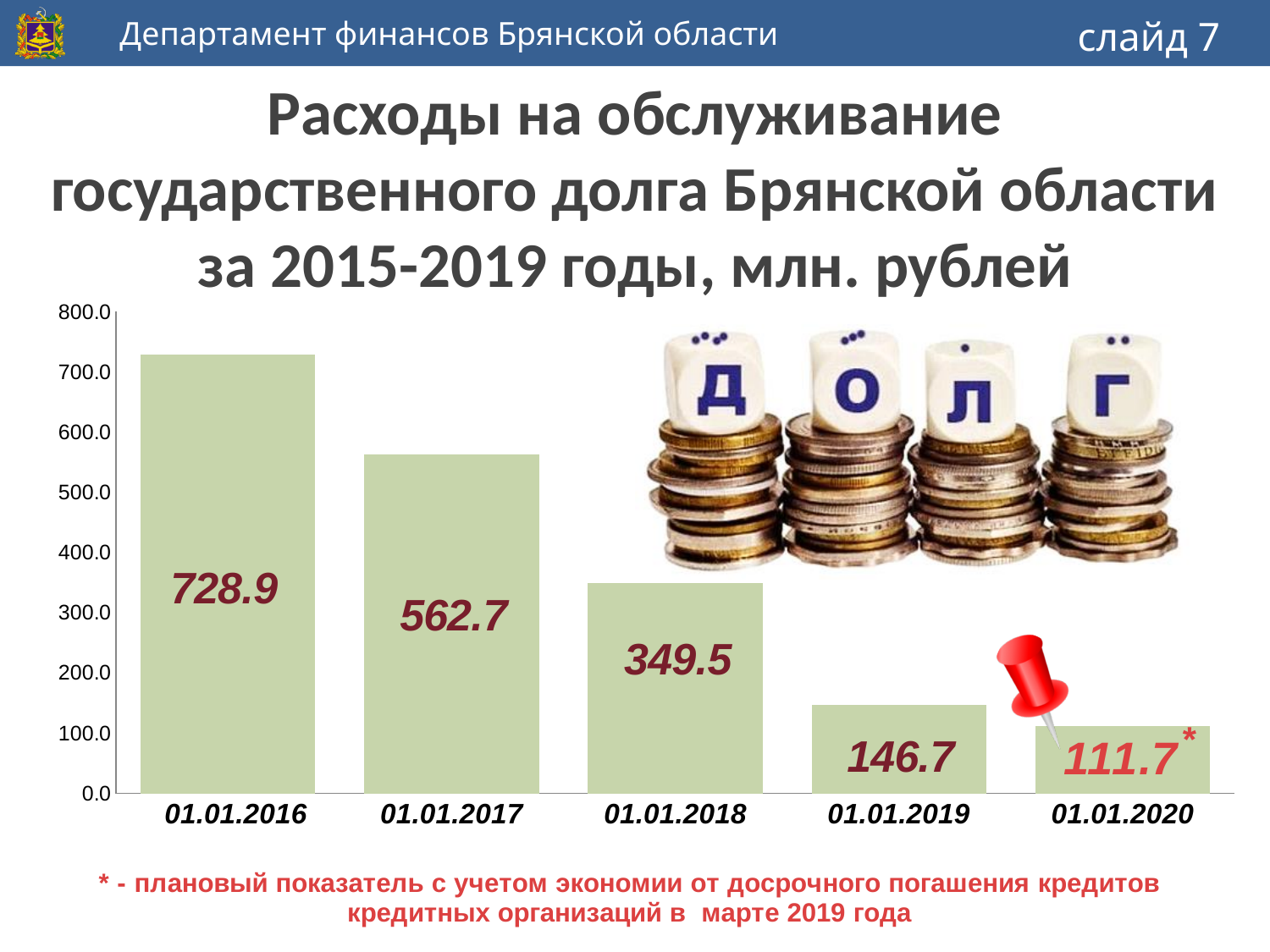
What is the value for 01.01.2018? 349.5 What is the difference between the values for 01.01.2016 and 01.01.2017? 166.2 What kind of chart is shown on the slide? bar chart Do the values rise or fall from 01.01.2016 to 01.01.2020? fall Is the value for 01.01.2019 greater or less than 200.0? less Which date has the lowest value? 01.01.2020 Which date has the highest value? 01.01.2016 What is the value for 01.01.2016? 728.9 Which is larger, the value for 01.01.2017 or the value for 01.01.2018? 01.01.2017 What is the difference between the values for 01.01.2019 and 01.01.2020? 35.0 What is the value for 01.01.2020? 111.7 How many bars are shown in the chart? 5